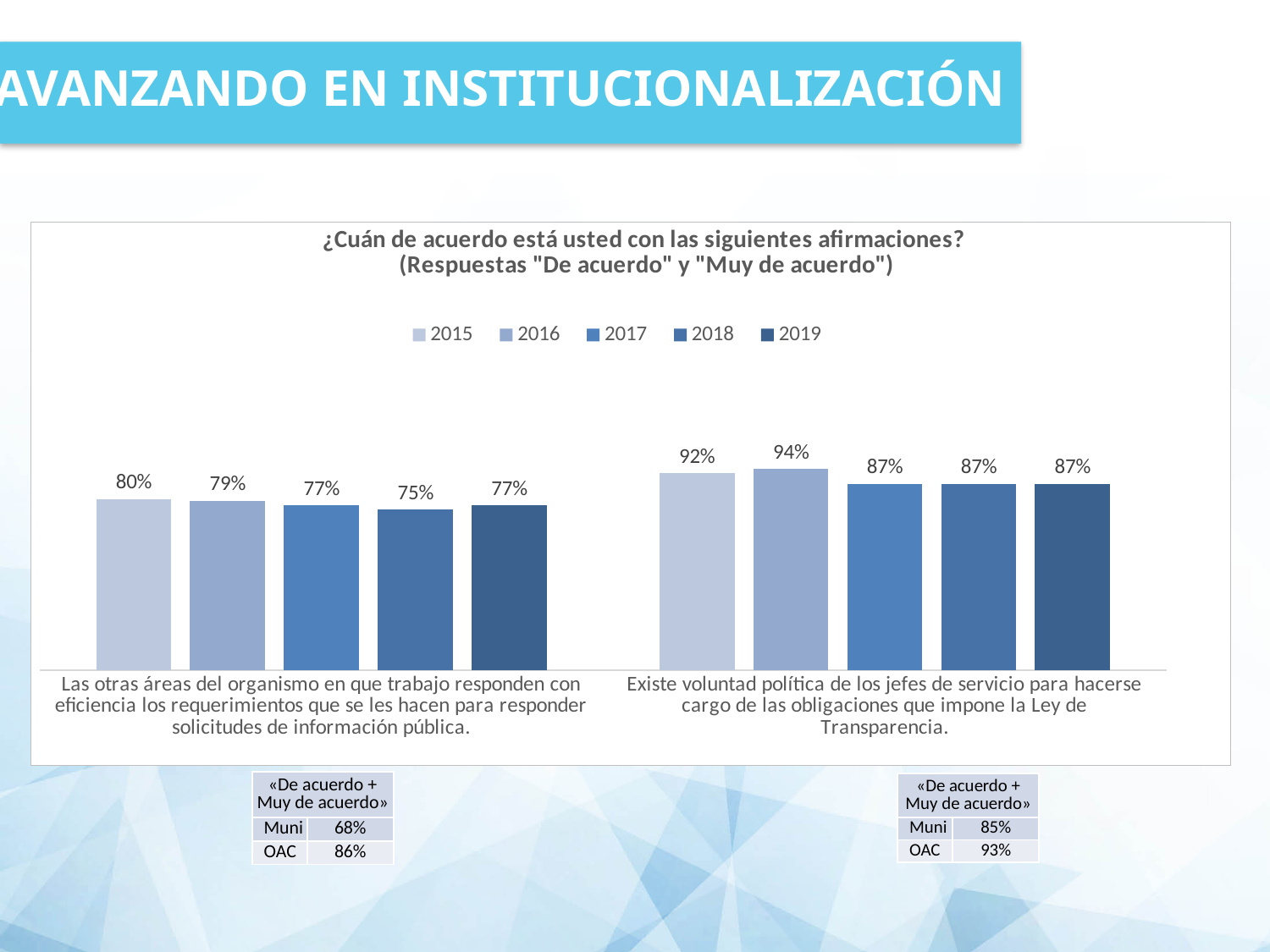
From 2015 to 2018, do the values for the statement 'Las otras áreas del organismo en que trabajo responden con eficiencia...' rise or fall? fall Which is larger: the 2015 value for 'Las otras áreas del organismo...' or the 2015 value for 'Existe voluntad política de los jefes de servicio...'? Existe voluntad política de los jefes de servicio... What kind of chart is shown on the slide? bar chart What is the 2019 value for the statement 'Existe voluntad política de los jefes de servicio para hacerse cargo de las obligaciones que impone la Ley de Transparencia'? 87% What is the difference between the 2016 and 2017 values for the statement 'Existe voluntad política de los jefes de servicio...'? 7% Which year has the lowest value for the statement 'Las otras áreas del organismo en que trabajo responden con eficiencia...'? 2018 How many categories (statements) are shown on the x axis? 2 What is the 2015 value for the statement 'Las otras áreas del organismo en que trabajo responden con eficiencia los requerimientos...'? 80% Which year has the highest value for the statement 'Existe voluntad política de los jefes de servicio...'? 2016 How many series does the legend list? 5 What is the 2018 value for the statement 'Las otras áreas del organismo en que trabajo responden con eficiencia los requerimientos...'? 75% What is the first line of the chart title? ¿Cuán de acuerdo está usted con las siguientes afirmaciones?